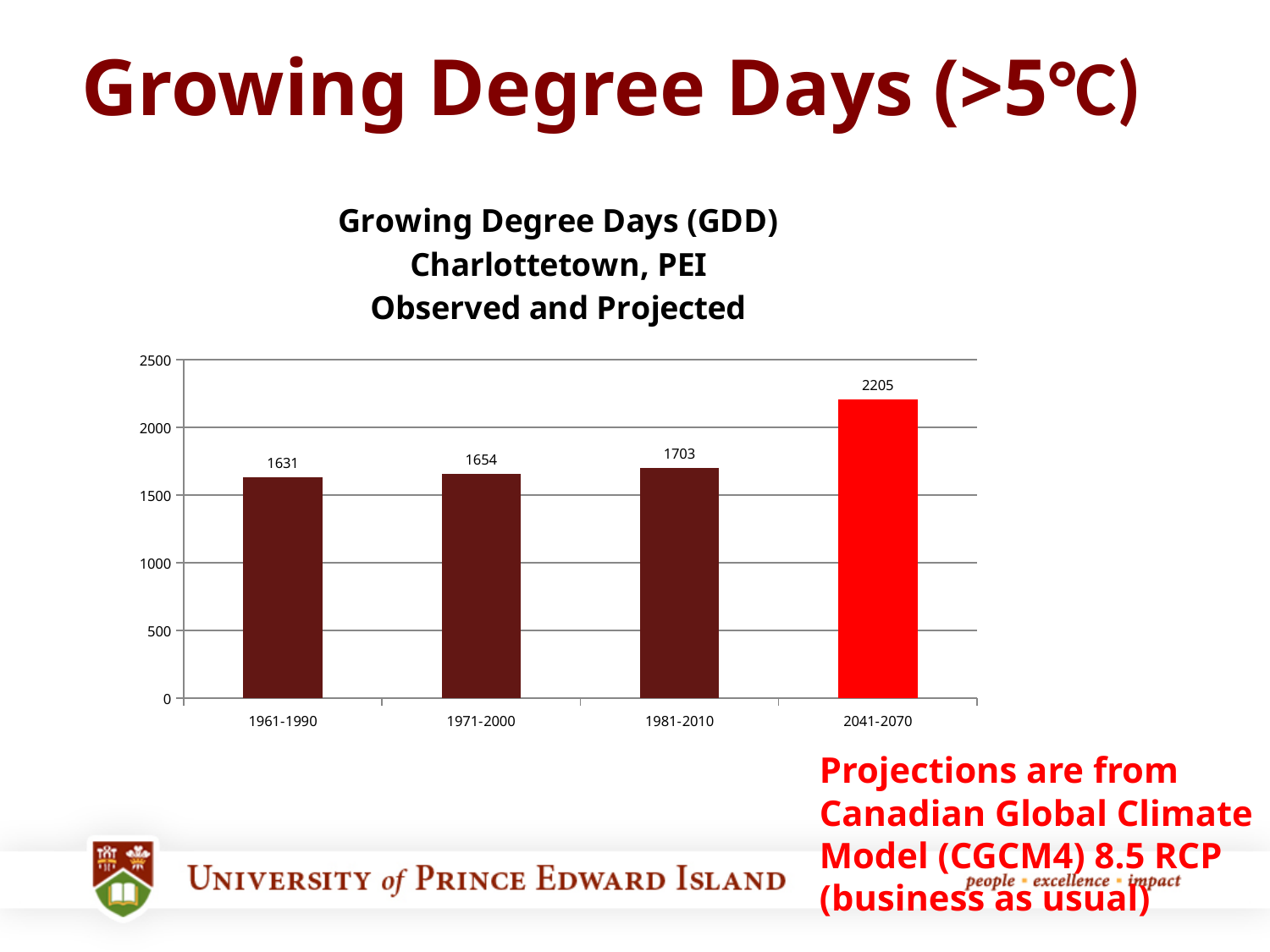
What is the value for 1981-2010? 1703 How many periods are shown on the x axis? 4 Which is larger, the value for 1981-2010 or the value for 1971-2000? 1981-2010 Which period has the lowest value? 1961-1990 What is the difference between the values for 2041-2070 and 1981-2010? 502 What is the value for 1961-1990? 1631 What is the value for 2041-2070? 2205 What is the difference between the values for 1971-2000 and 1961-1990? 23 Do the values rise or fall from 1961-1990 to 2041-2070? rise What kind of chart is this? bar chart Which period has the highest value? 2041-2070 Is the value for 2041-2070 greater or less than 2000? greater